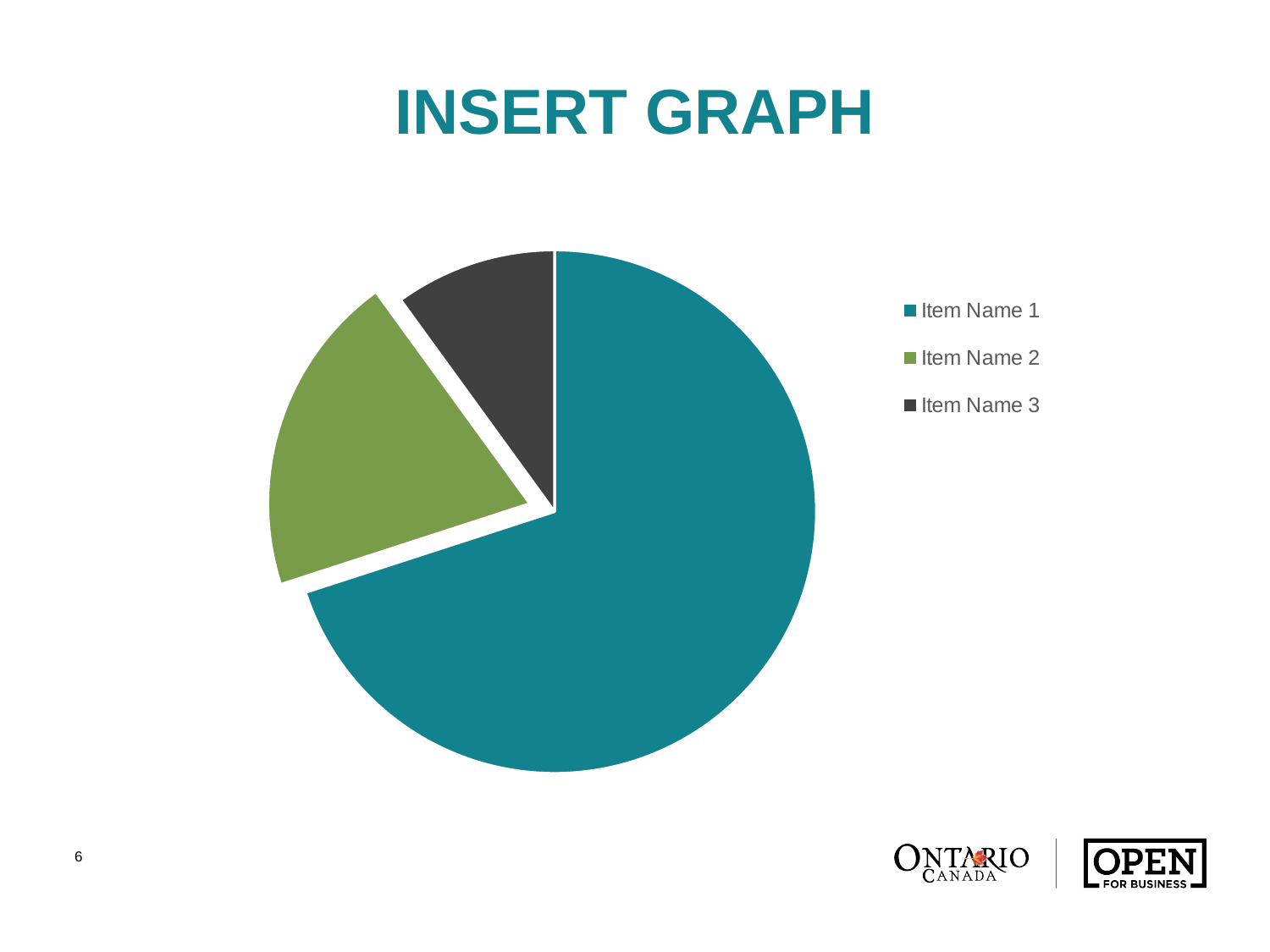
How many entries does the legend list? 3 Which category has the smallest slice of the pie? Item Name 3 Which slice is larger, Item Name 2 or Item Name 3? Item Name 2 Does Item Name 1 take up more or less than half of the pie? more What is the title of the slide containing the pie chart? INSERT GRAPH Which category has the largest slice of the pie? Item Name 1 Which slice is larger, Item Name 1 or Item Name 2? Item Name 1 What colour is the slice for Item Name 2? green What kind of chart is shown on the slide? pie chart How many slices does the pie chart have? 3